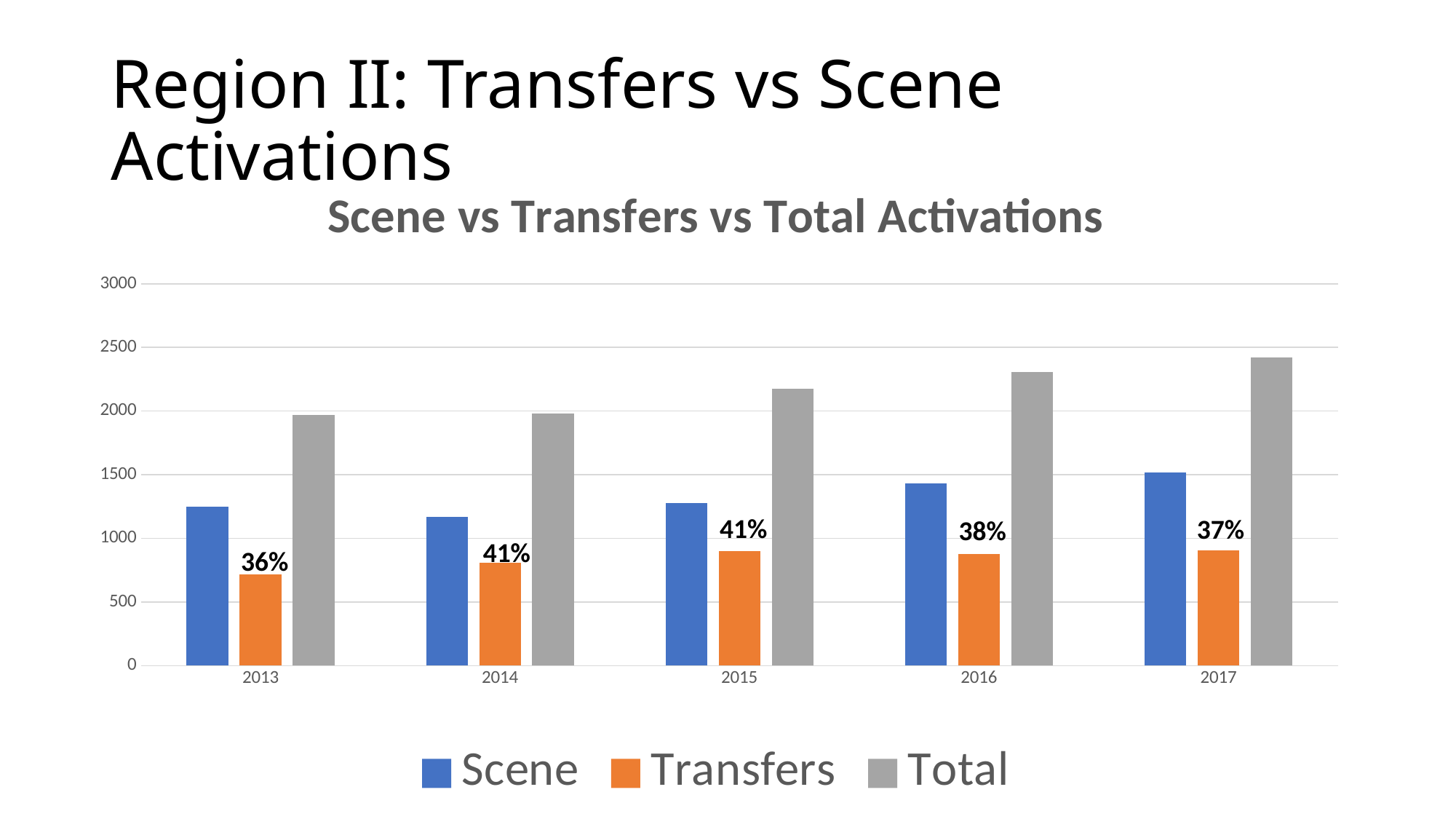
Is the Total value for 2017 greater or less than 2000? greater How many series does the legend list? 3 What percentage label is printed above the Transfers bar for 2013? 36% Does the Total series rise or fall from 2013 to 2017? rise Which is larger in 2015, the Scene bar or the Transfers bar? Scene In which year is the Total bar the highest? 2017 In which year is the Scene bar the lowest? 2014 What percentage label is printed above the Transfers bar for 2016? 38% What percentage label is printed above the Transfers bar for 2017? 37% Is the Total value for 2013 greater or less than 2000? less How many years are shown on the x axis? 5 What kind of chart is shown on the slide? bar chart